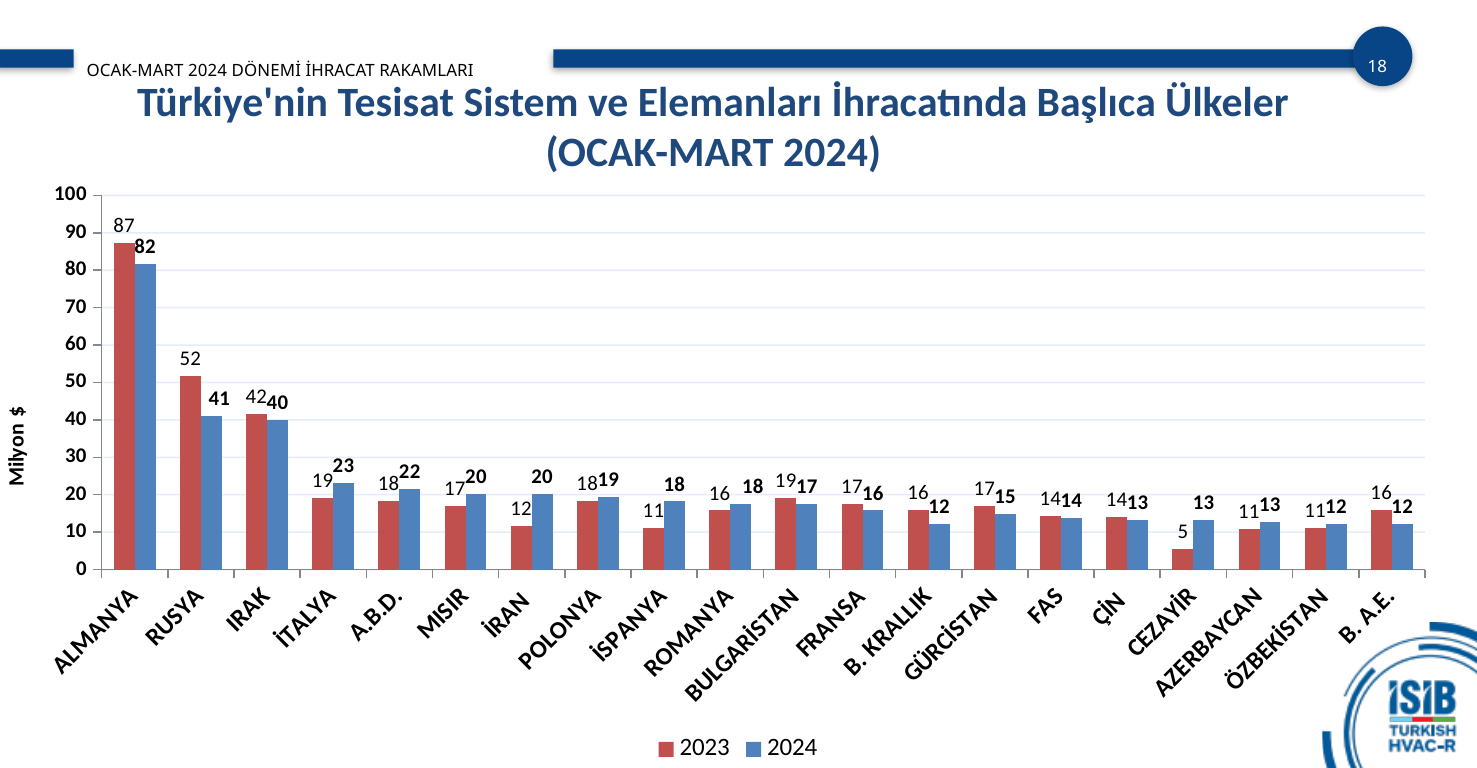
How many series does the legend list? 2 What is the label of the y axis? Milyon $ What is the 2023 value for RUSYA? 52 What is the 2024 value for CEZAYİR? 13 Which country has the highest 2023 value? ALMANYA Which is larger for İRAN: the 2023 value or the 2024 value? 2024 What is the 2024 value for ALMANYA? 82 How many countries are shown on the x axis? 20 What kind of chart is shown on the slide? bar chart What is the difference between the 2023 and 2024 values for RUSYA? 11 Is the 2024 value for IRAK greater or less than 50? less Which country has the lowest 2023 value? CEZAYİR